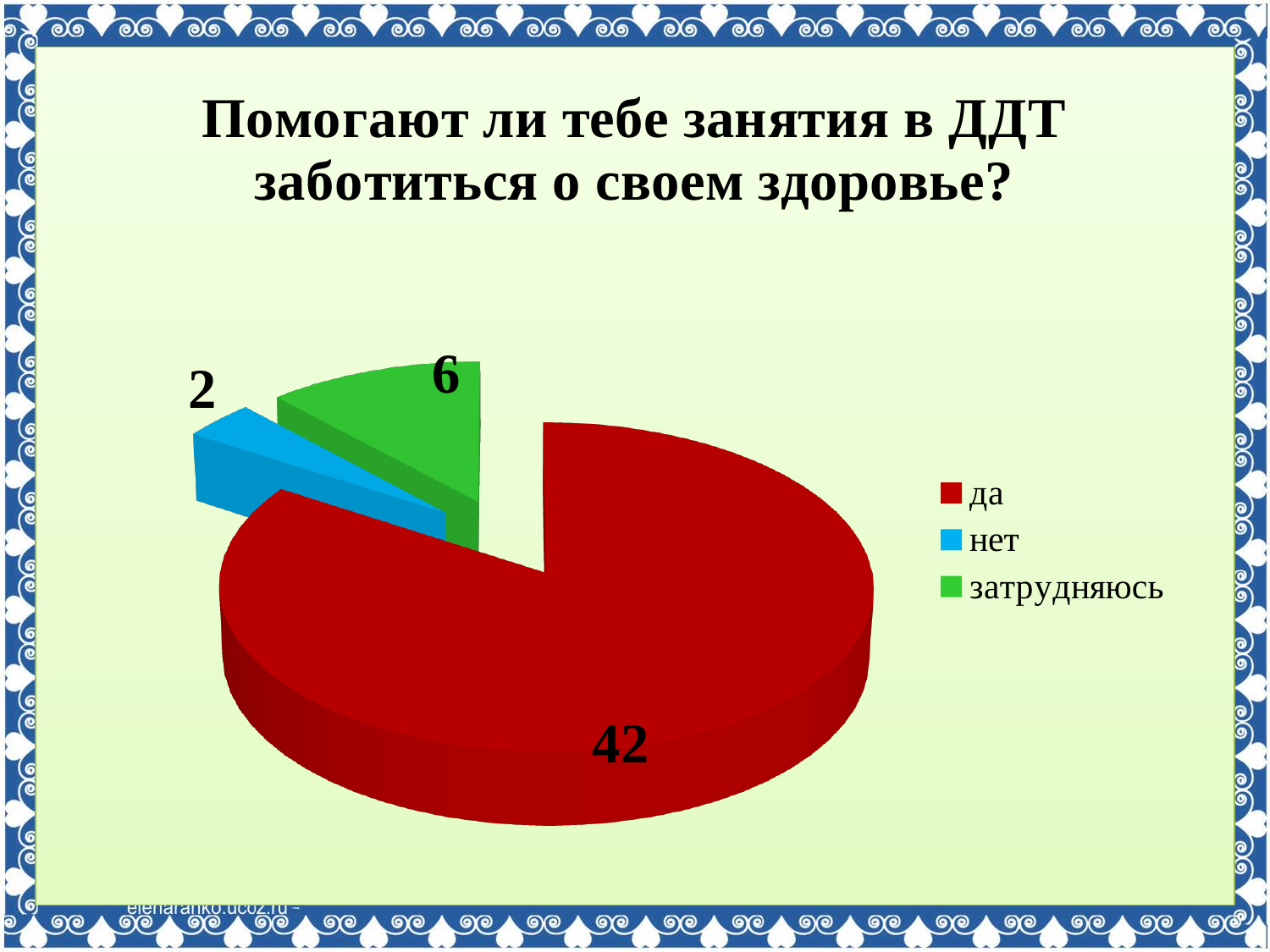
How many categories does the pie chart have? 3 Which category has the largest slice? да Which category has the smallest slice? нет What is the value for "затрудняюсь"? 6 What share of the pie does the "да" slice represent? 84% What is the value for "да"? 42 Which is larger, the value for "затрудняюсь" or the value for "нет"? затрудняюсь What is the value for "нет"? 2 What kind of chart is shown on the slide? pie chart What colour is the "затрудняюсь" slice? green What is the difference between the values for "затрудняюсь" and "нет"? 4 What is the difference between the values for "да" and "затрудняюсь"? 36